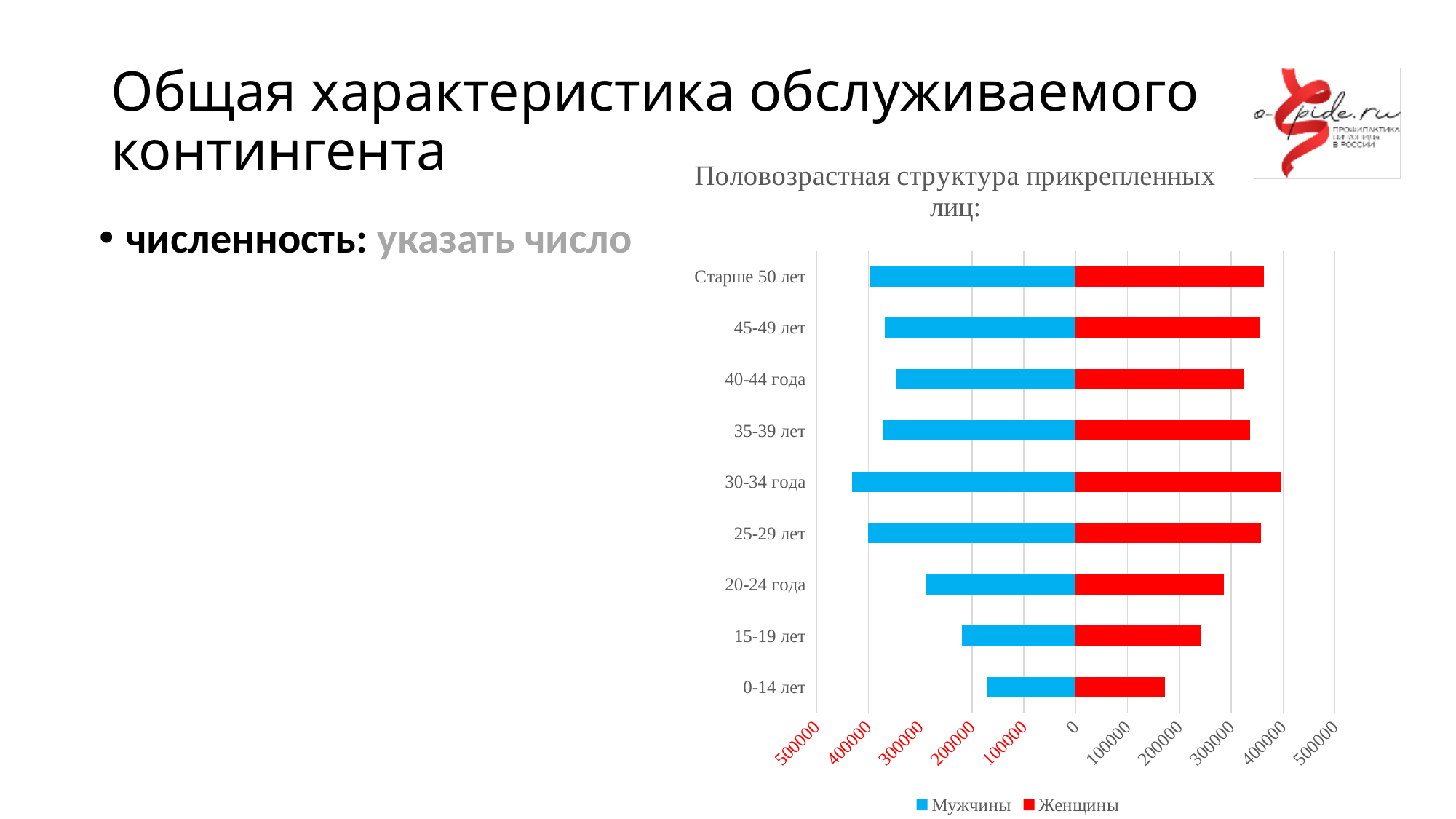
What kind of chart is shown on the slide? bar chart Which age group has the smallest value for Мужчины? 0-14 лет Which age group has the largest value for Женщины? 30-34 года For Мужчины, which is larger: the 30-34 года group or the 20-24 года group? 30-34 года Is the value for Мужчины in the 30-34 года group greater or less than 400000? greater Is the value for Женщины in the 15-19 лет group greater or less than 200000? greater How many series does the legend list? 2 Which colour represents Женщины in the chart? red How many age groups are shown on the chart? 9 Which age group has the smallest value for Женщины? 0-14 лет Which age group has the largest value for Мужчины? 30-34 года Is the value for Женщины in the 0-14 лет group greater or less than 200000? less